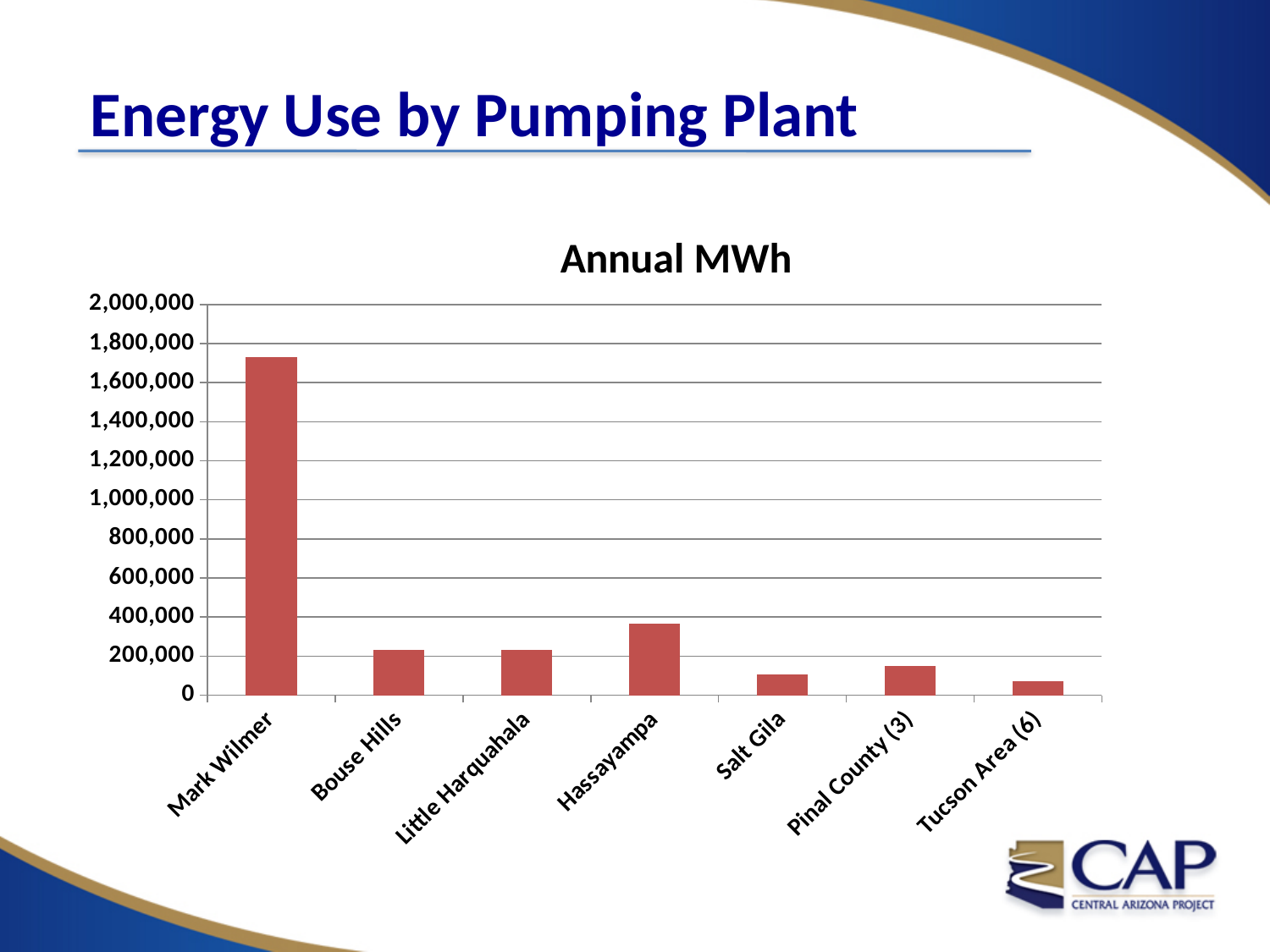
What kind of chart is shown on the slide? bar chart Is the value for Mark Wilmer greater or less than 1,600,000? greater Is the value for Salt Gila greater or less than 200,000? less Which pumping plant has the highest annual MWh? Mark Wilmer What is the highest value shown on the y axis of the chart? 2,000,000 Which pumping plant has the lowest annual MWh? Tucson Area (6) What is the title of the chart? Annual MWh How many pumping plants are shown on the x axis of the chart? 7 Which has a higher annual MWh, Hassayampa or Bouse Hills? Hassayampa Is the value for Tucson Area (6) greater or less than 200,000? less Which has a higher annual MWh, Pinal County (3) or Tucson Area (6)? Pinal County (3)